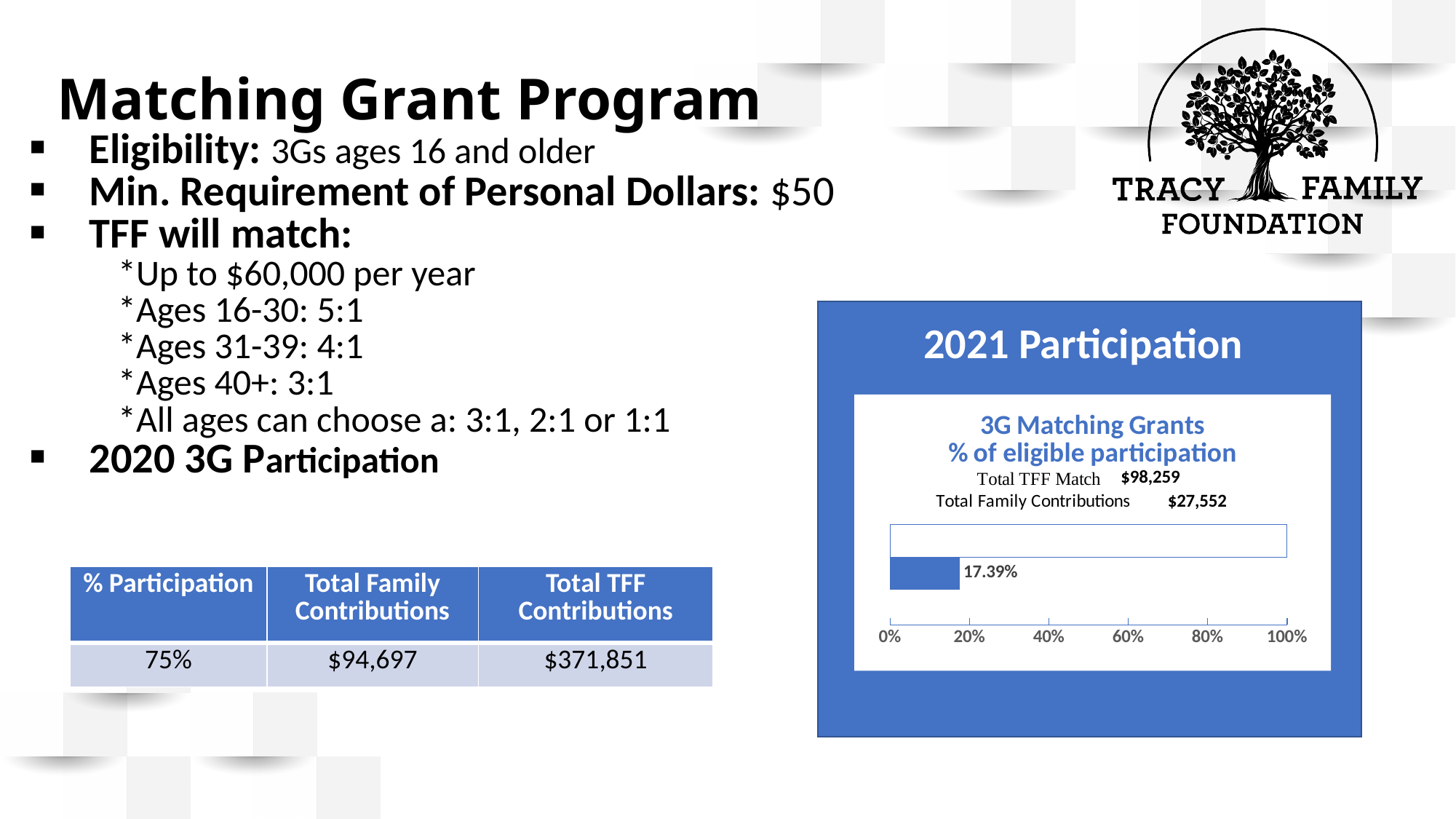
What is the title of the chart on the right side of the slide? 3G Matching Grants % of eligible participation In the 3G Matching Grants chart, what is the difference between the Total TFF Match and the Total Family Contributions? $70,707 What is the Total TFF Match shown in the 3G Matching Grants chart? $98,259 What are the Total Family Contributions shown in the 3G Matching Grants chart? $27,552 How many data labels are printed on the bars of the 3G Matching Grants chart? 1 In the 3G Matching Grants chart, which is larger: the Total TFF Match or the Total Family Contributions? Total TFF Match In the 3G Matching Grants chart, what percentage of eligible participation does the filled bar show? 17.39% What kind of chart is shown under the "2021 Participation" heading? bar chart In the 3G Matching Grants chart, is the participation value greater or less than 40%? less What is the maximum value shown on the x axis of the 3G Matching Grants chart? 100% In the 3G Matching Grants chart, is the participation value greater or less than 20%? less